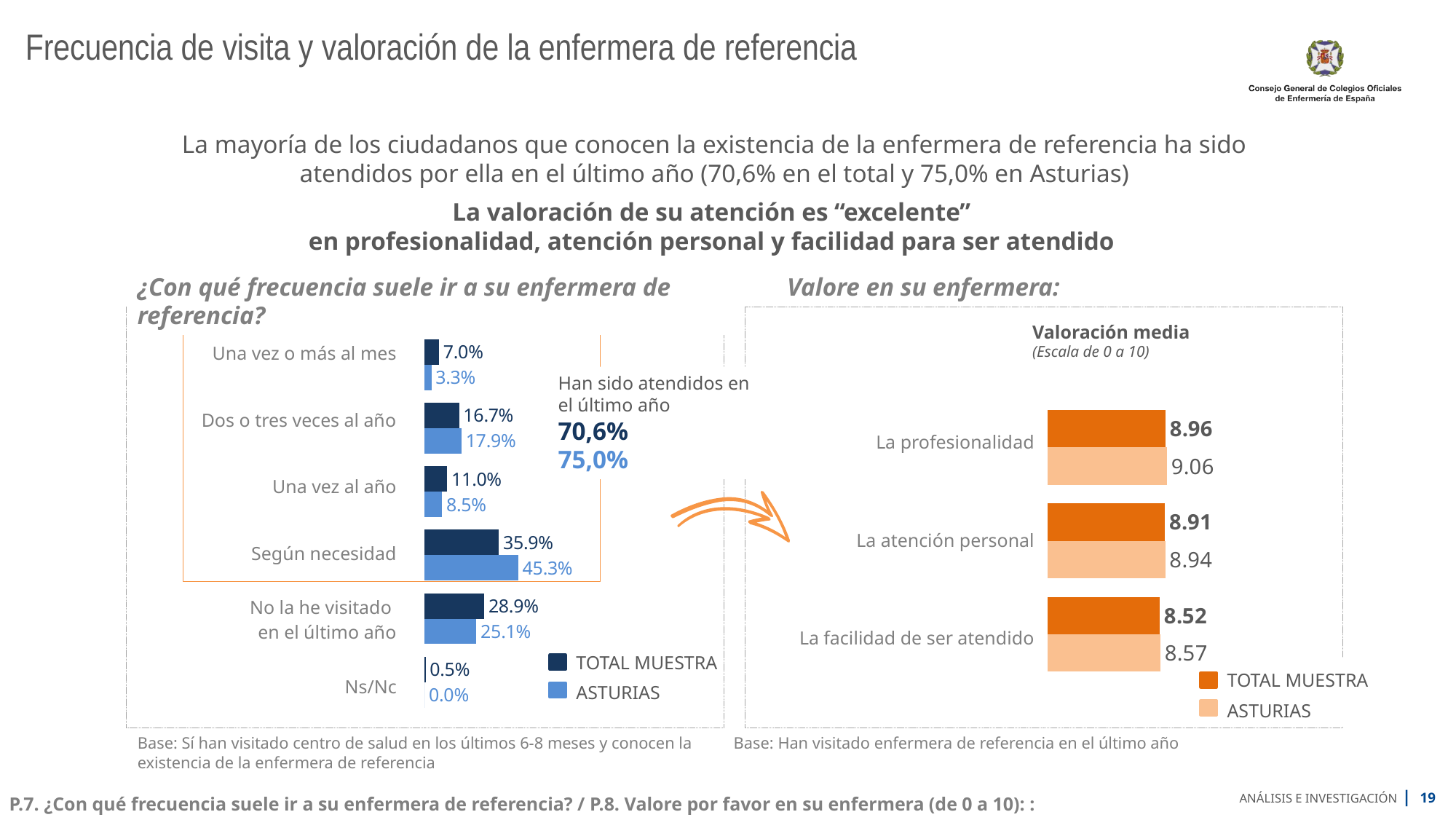
In the left chart on visit frequency, what is the difference between the ASTURIAS and TOTAL MUESTRA values for 'Según necesidad'? 9.4 percentage points In the right chart 'Valore en su enfermera', what is the ASTURIAS score for 'La profesionalidad'? 9.06 In the left chart on visit frequency, which category has the lowest TOTAL MUESTRA value? Ns/Nc In the left chart on visit frequency, which is larger for 'Una vez al año': TOTAL MUESTRA or ASTURIAS? TOTAL MUESTRA How many categories does the left chart on visit frequency show? 6 What type of chart is the right chart 'Valore en su enfermera'? Bar chart How many series does the legend of the left chart on visit frequency list? 2 In the left chart on visit frequency, what is the ASTURIAS value for 'Dos o tres veces al año'? 17.9% In the left chart on visit frequency, which category has the highest ASTURIAS value? Según necesidad In the left chart on visit frequency, what is the TOTAL MUESTRA value for 'Según necesidad'? 35.9% In the right chart 'Valore en su enfermera', which aspect has the lowest TOTAL MUESTRA score? La facilidad de ser atendido In the right chart 'Valore en su enfermera', what is the difference between the TOTAL MUESTRA scores for 'La profesionalidad' and 'La facilidad de ser atendido'? 0.44